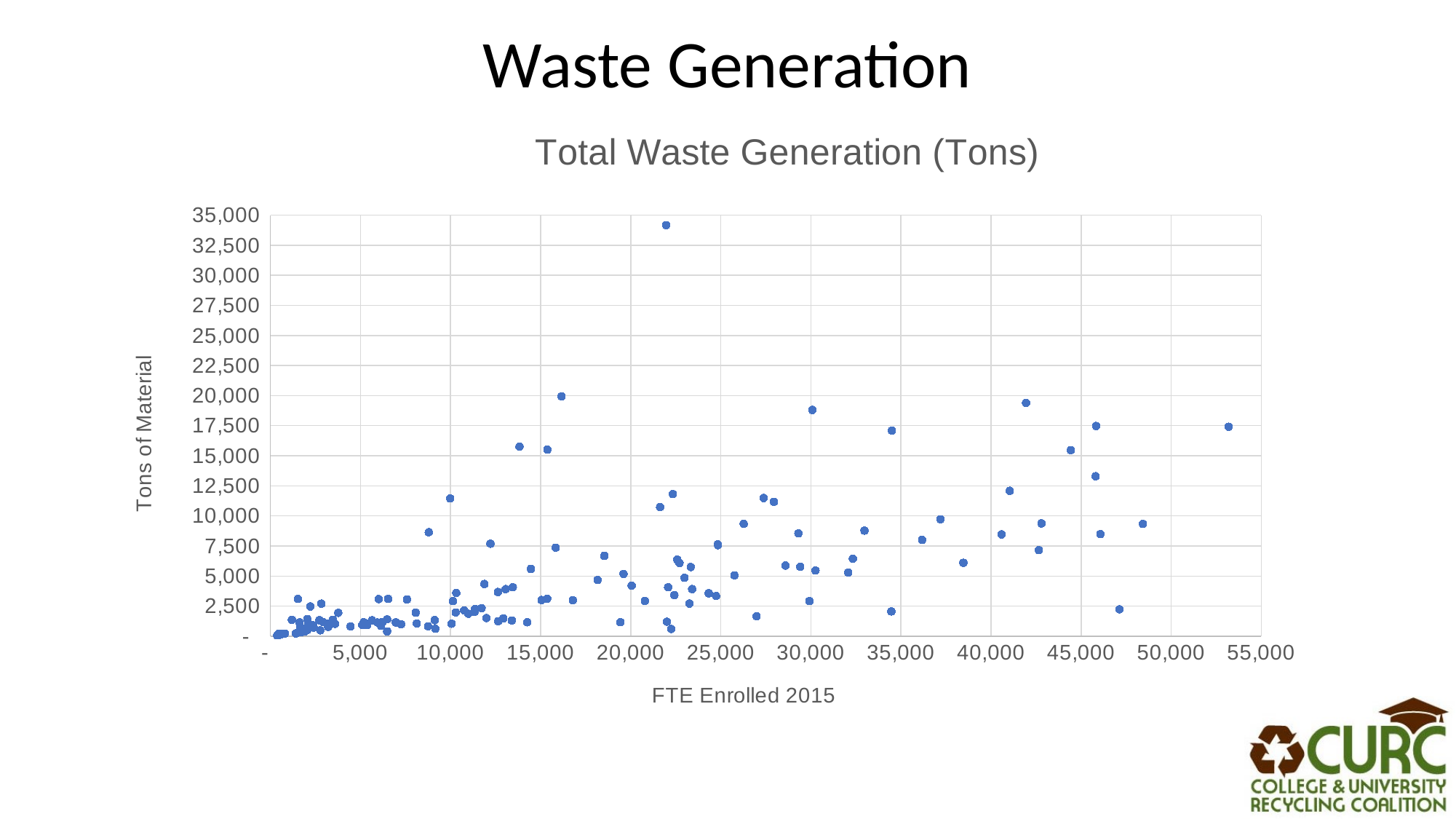
What is the label of the x axis of the chart? FTE Enrolled 2015 Is the highest point on the chart greater or less than 30,000 tons of material? greater Is the point with the largest FTE enrollment (around 53,000) greater or less than 20,000 tons of material? less Do the tons of material generally rise or fall as FTE enrolled increases? rise What kind of chart is shown on the slide? Scatter plot Is the highest point on the chart located at an FTE enrollment greater or less than 30,000? less Which is larger: the tons of material for the highest point near 22,000 FTE, or the tons of material for the point near 16,000 FTE at about 20,000 tons? The point near 22,000 FTE What is the title of the chart? Total Waste Generation (Tons)